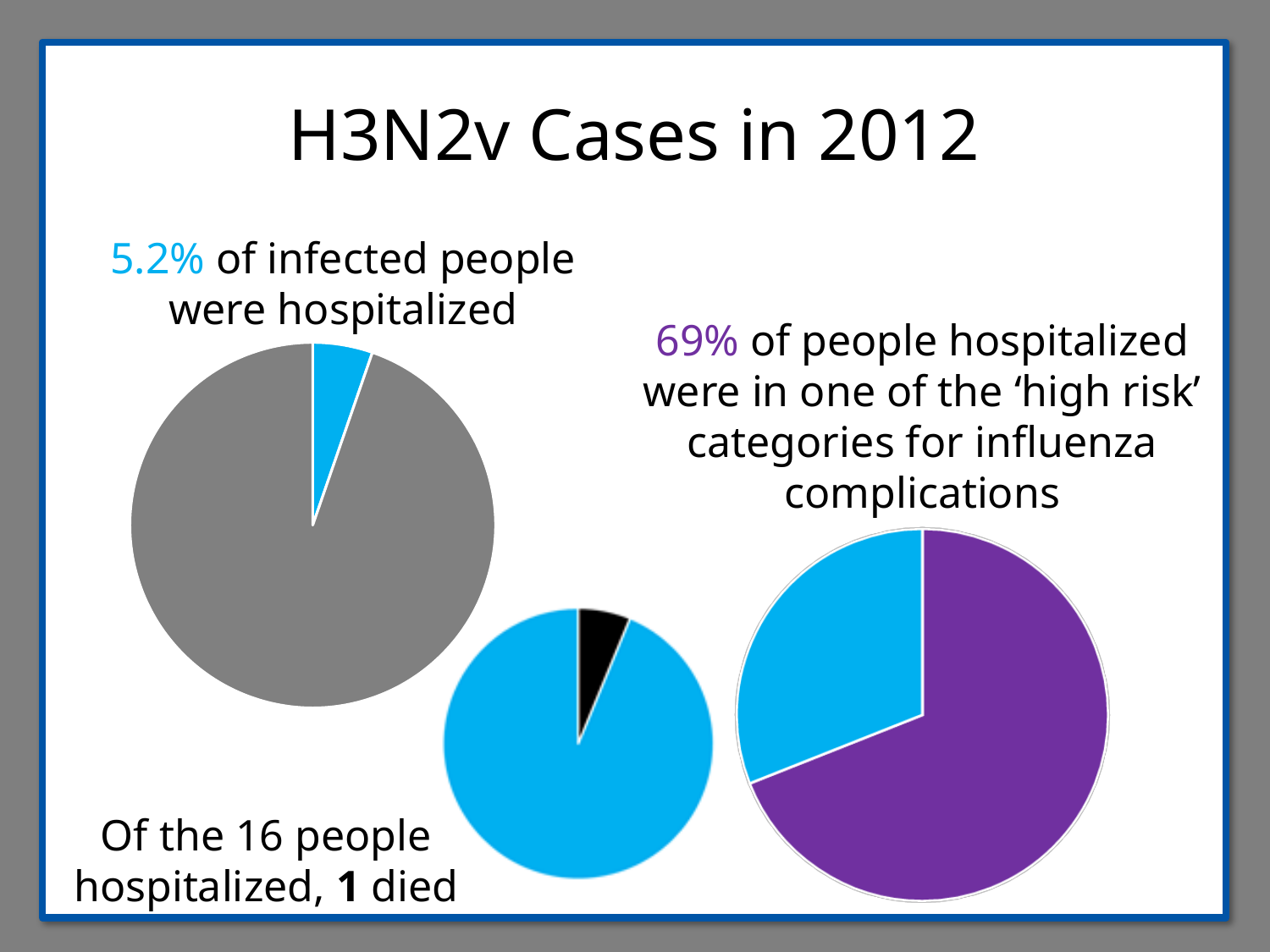
In the left pie chart, which slice is larger, the grey one or the blue one? Grey How many pie charts are on the slide? 3 In the right pie chart, which slice is larger, the purple one or the blue one? Purple What kind of charts are shown on the slide? Pie charts According to the text next to the middle pie chart, how many people were hospitalized? 16 What is the title of the slide? H3N2v Cases in 2012 In the middle pie chart, what colour is the slice representing the person who died? Black How many slices does each pie chart on the slide have? 2 In the left pie chart, what share of infected people were hospitalized (the blue slice)? 5.2% According to the text next to the middle pie chart, how many of the hospitalized people died? 1 In the right pie chart, what share of hospitalized people were in one of the 'high risk' categories (the purple slice)? 69%